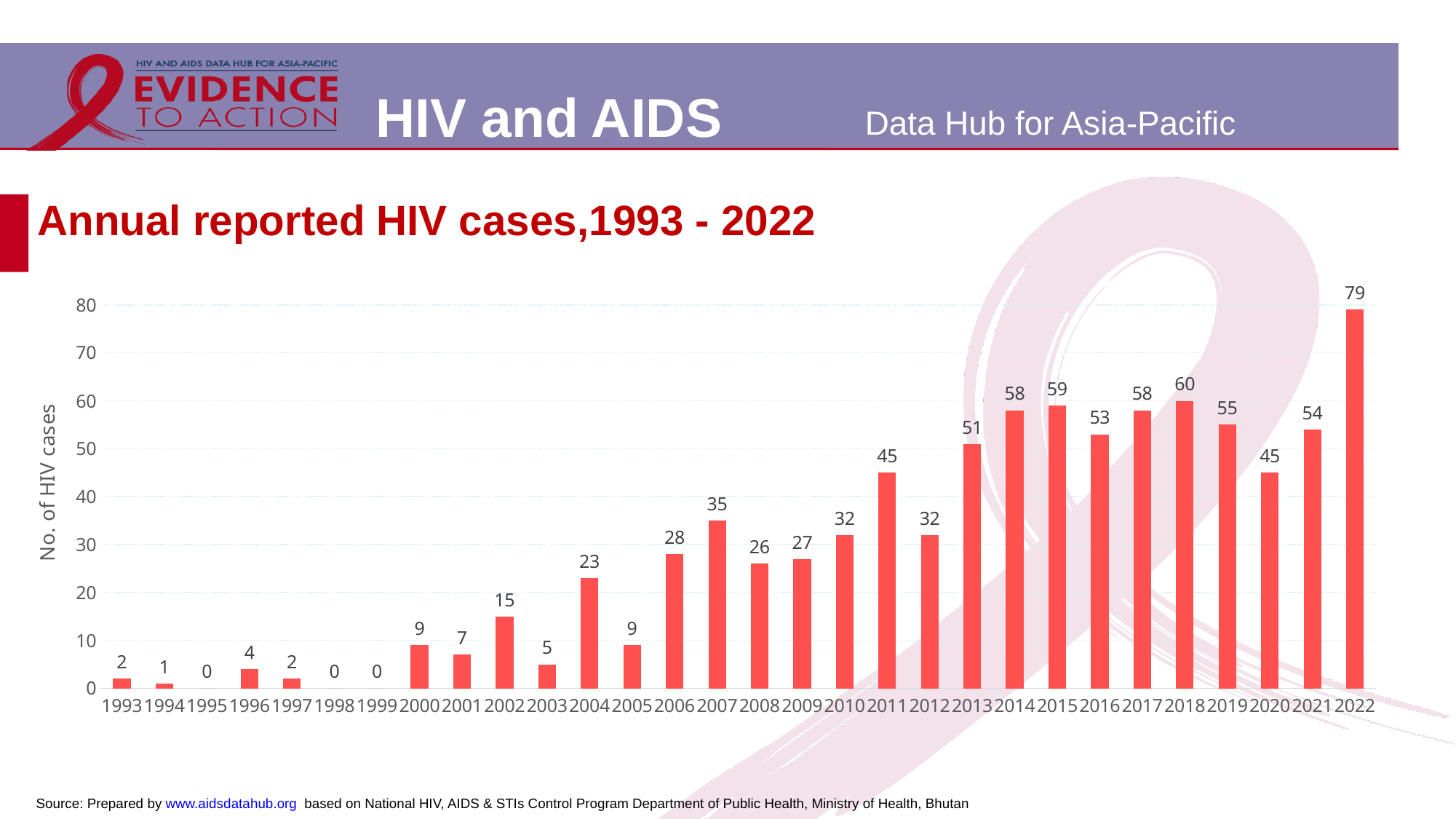
Overall, do the reported HIV cases rise or fall from 1993 to 2022? Rise Which year has the highest number of reported HIV cases? 2022 What type of chart is used to show annual reported HIV cases? Bar chart How many years are shown on the x axis of the chart? 30 What is the difference in reported HIV cases between 2022 and 2021? 25 What is the number of HIV cases reported in 2011? 45 Which year had more reported HIV cases, 2016 or 2019? 2019 How many HIV cases were reported in 2022? 79 How many HIV cases were reported in 2002? 15 What is the label of the y axis of the chart? No. of HIV cases What is the difference in reported HIV cases between 2018 and 2020? 15 Which year had more reported HIV cases, 2007 or 2012? 2007